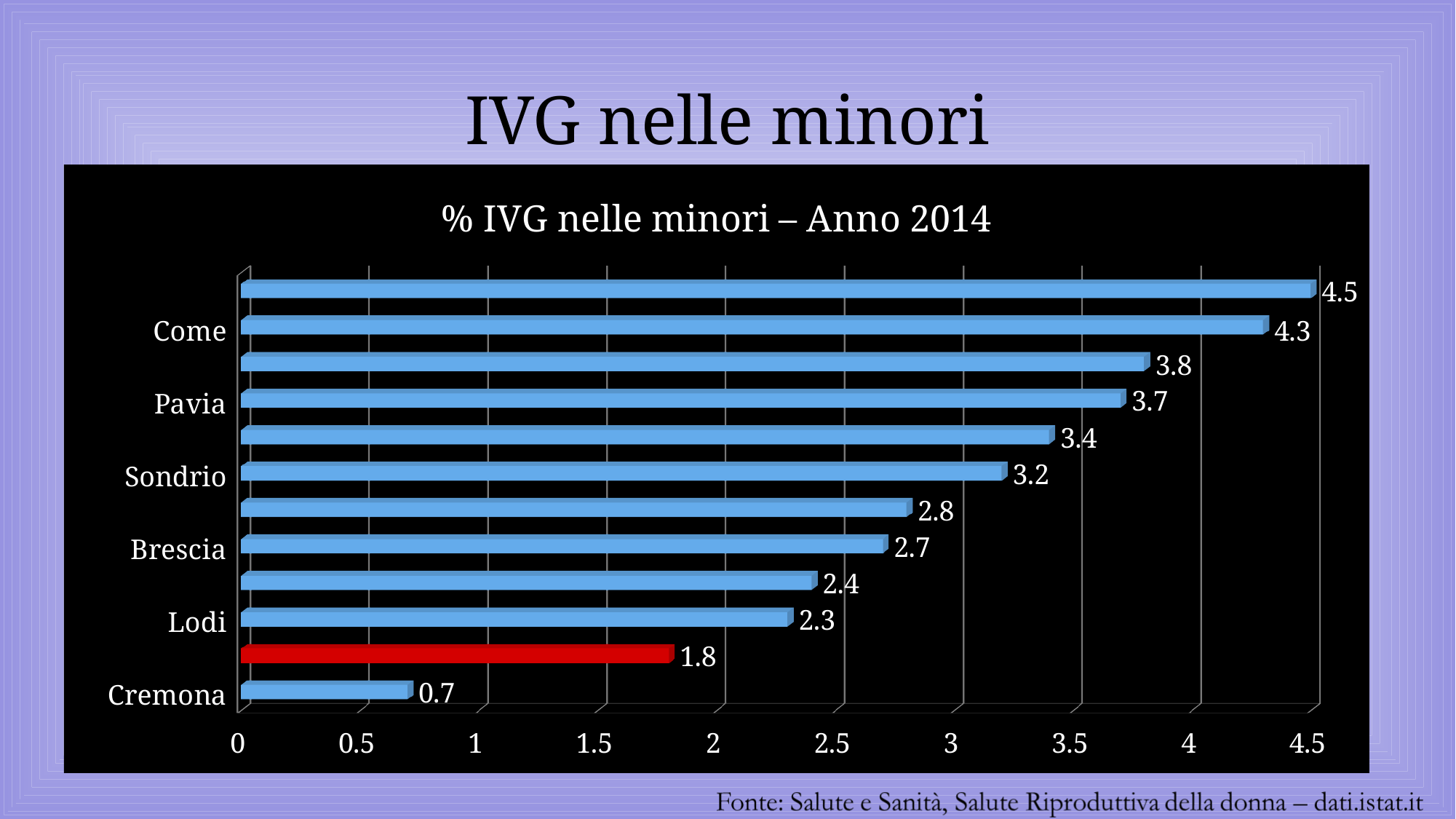
Which is larger, the value for Sondrio or the value for Brescia? Sondrio What value is shown by the red bar? 1.8 What is the value for Brescia? 2.7 What is the highest value shown on the chart? 4.5 Which labelled category has the lowest value? Cremona What is the difference between the values for Come and Pavia? 0.6 What is the value for Pavia? 3.7 What is the value for Sondrio? 3.2 What is the value for Come? 4.3 How many bars are plotted on the chart? 12 What is the value for Cremona? 0.7 What is the value for Lodi? 2.3